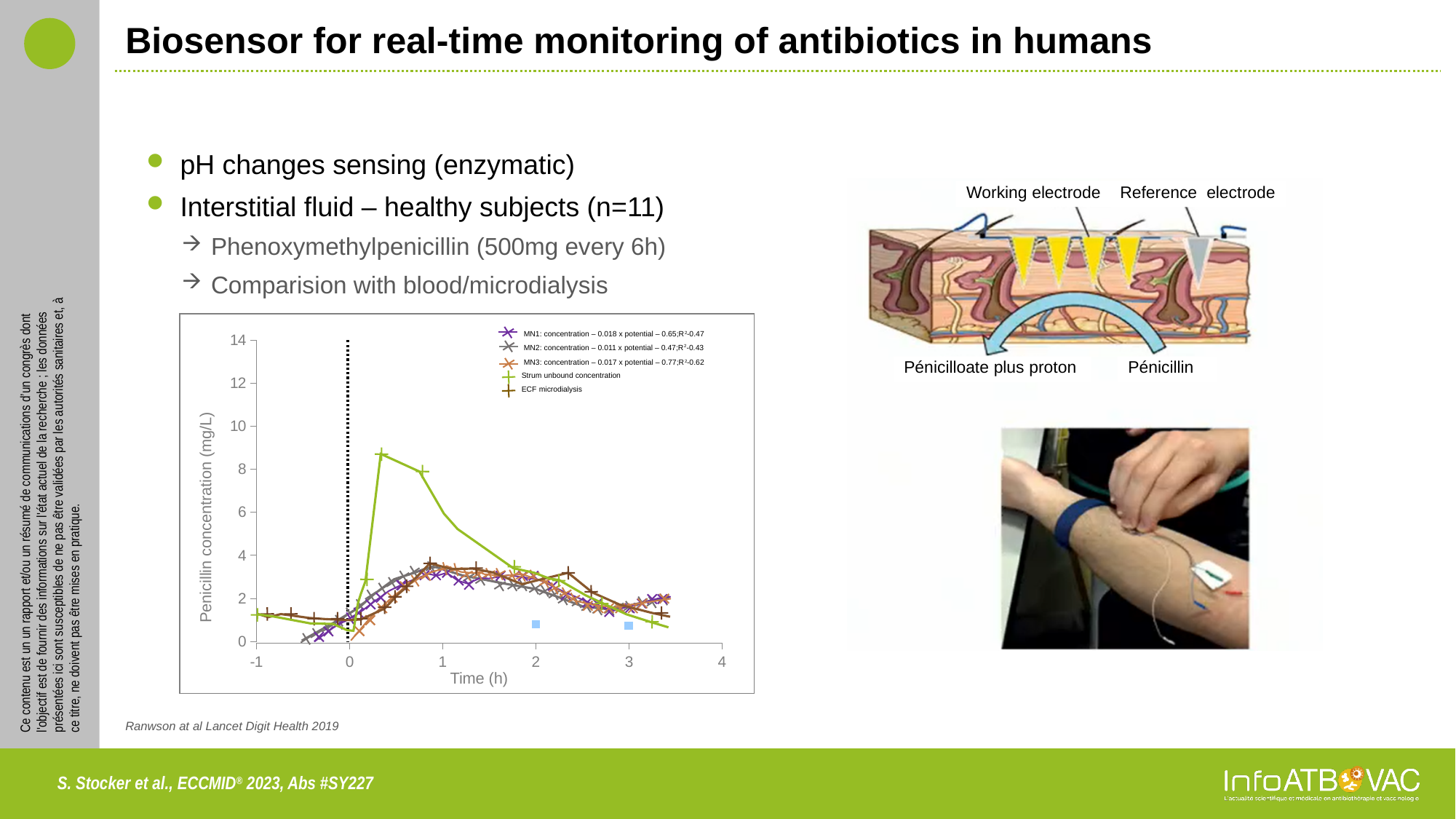
Does the Strum unbound concentration rise or fall between 1 h and 3 h? fall What is the highest value shown on the y-axis of the chart? 14 Which series reaches the highest peak concentration in the chart? Strum unbound concentration What is the label of the x-axis of the chart? Time (h) What kind of chart is shown on the slide? line chart Is the Strum unbound concentration at 3 h greater or less than 4 mg/L? less How many series does the chart legend list? 5 At about 0.3 h, which is larger: the Strum unbound concentration or the ECF microdialysis concentration? Strum unbound concentration What is the label of the y-axis of the chart? Penicillin concentration (mg/L) Is the peak value of the Strum unbound concentration series greater or less than 6 mg/L? greater Is the peak value of the ECF microdialysis series greater or less than 6 mg/L? less